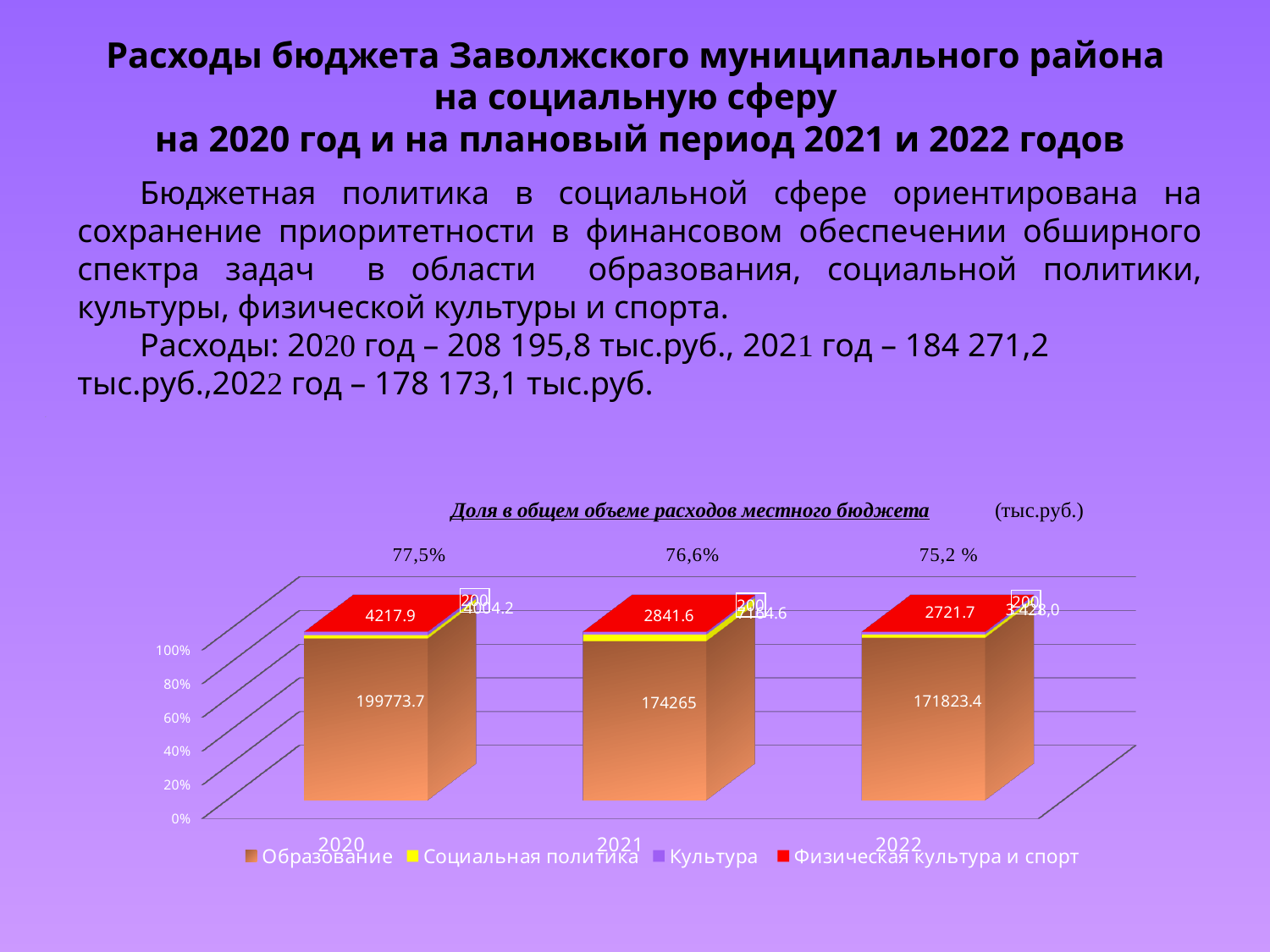
What is the value for Физическая культура и спорт in 2022? 200 Do the values for Образование rise or fall from 2020 to 2022? fall What is the value for Образование in 2021? 174265 How many series does the chart legend list? 4 In which year is the value for Образование the highest? 2020 What kind of chart is shown on the slide? bar chart How many years (categories) are shown on the x axis of the chart? 3 What is the value for Физическая культура и спорт in 2020? 200 What is the value for Образование in 2020? 199773.7 What is the value for Образование in 2022? 171823.4 What is the difference between the Образование values for 2020 and 2021? 25508.7